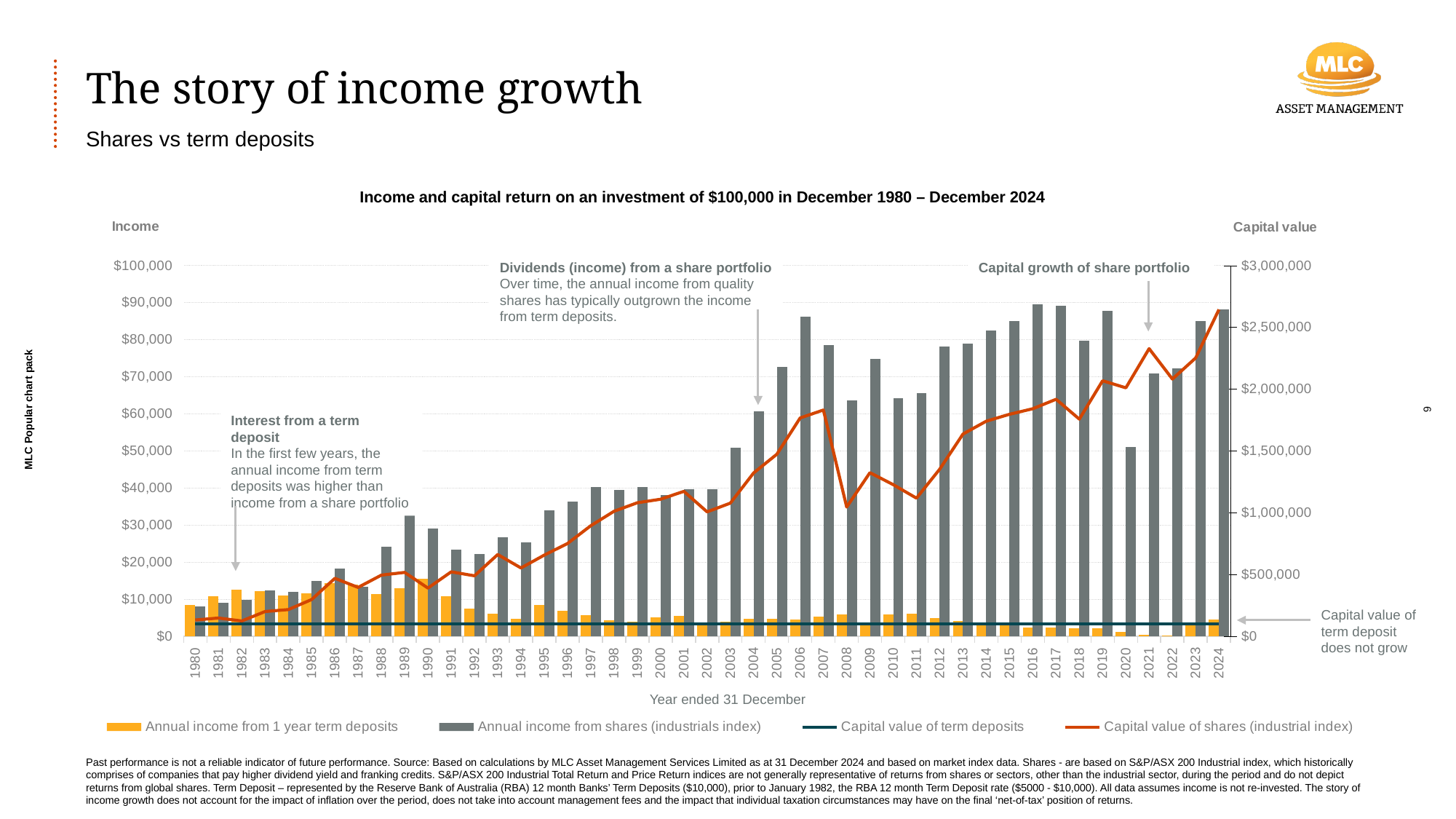
How many series does the chart legend list? 4 In 1982, which is larger: annual income from 1 year term deposits or annual income from shares (industrials index)? Annual income from 1 year term deposits Which year has the lowest annual income from 1 year term deposits? 2022 Is the annual income from shares (industrials index) in 2006 greater or less than $80,000? greater What kind of chart is shown on the slide? Combination bar and line chart Overall, does the capital value of shares (industrial index) rise or fall from 1980 to 2024? Rise How many years are shown along the x axis of the chart? 45 Is the capital value of shares (industrial index) in 2008 greater or less than $1,500,000? less Is the capital value of shares (industrial index) in 2024 greater or less than $2,500,000? greater What is the title of the chart? Income and capital return on an investment of $100,000 in December 1980 – December 2024 Which is larger: annual income from shares (industrials index) in 2006 or in 2007? 2006